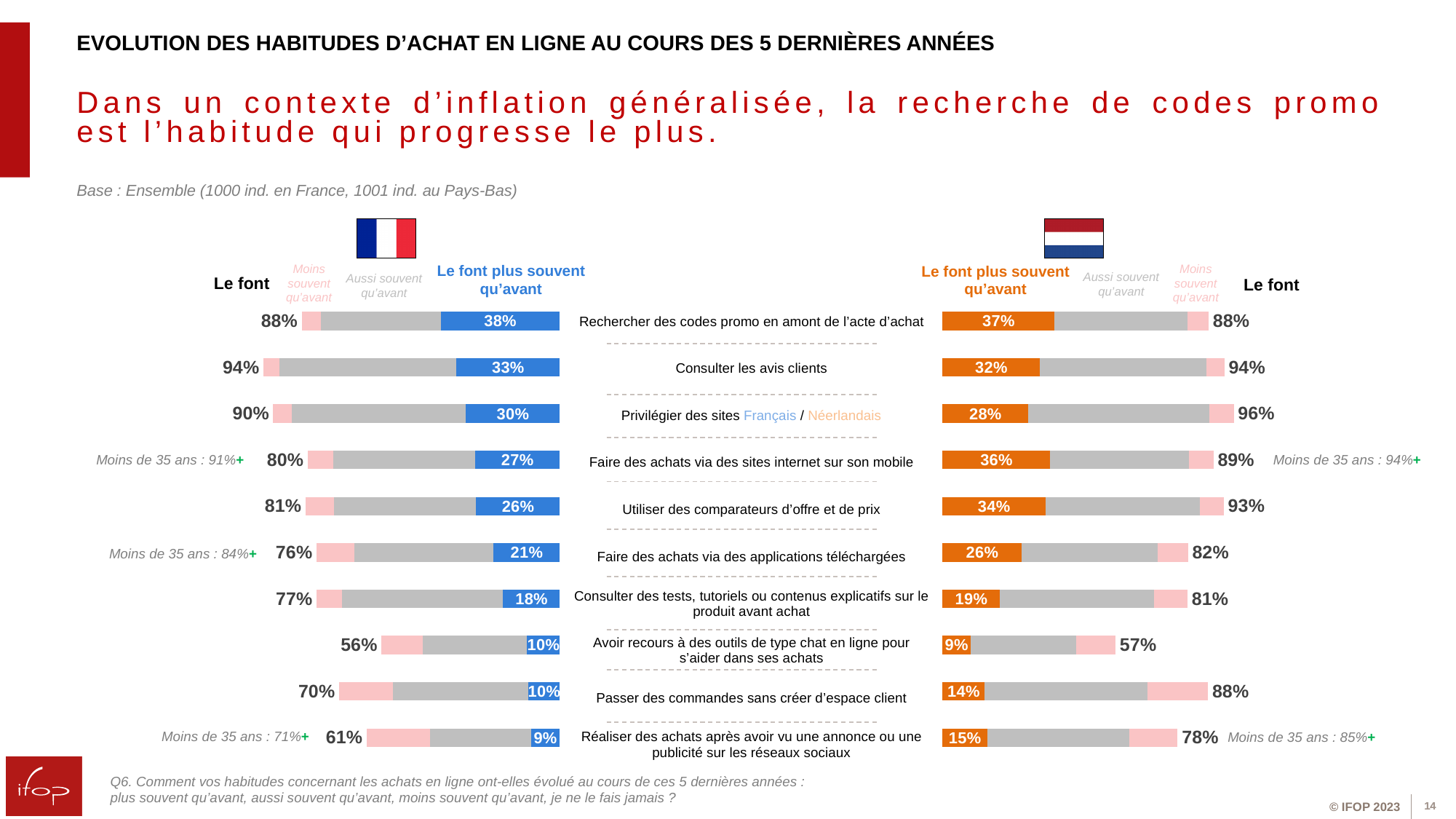
What colour represents "Le font plus souvent qu'avant" in the Netherlands chart (right)? Orange What type of chart is used on this slide? Stacked bar chart For "Privilégier des sites Français / Néerlandais", which country has the higher "Le font" percentage, France or the Netherlands? Netherlands In the France chart (left), which habit has the highest "Le font plus souvent qu'avant" percentage? Rechercher des codes promo en amont de l'acte d'achat How many online shopping habits are listed in the charts? 10 In the France chart (left), which habit has the lowest "Le font" percentage? Avoir recours à des outils de type chat en ligne pour s'aider dans ses achats In the Netherlands chart (right), which habit has the lowest "Le font plus souvent qu'avant" percentage? Avoir recours à des outils de type chat en ligne pour s'aider dans ses achats What is the difference between the France and Netherlands "Le font plus souvent qu'avant" percentages for "Utiliser des comparateurs d'offre et de prix"? 8 points In the France chart (left), what is the "Le font" percentage for "Faire des achats via des applications téléchargées" among those under 35 ("Moins de 35 ans")? 84% In the Netherlands chart (right), what percentage do "Faire des achats via des sites internet sur son mobile" more often than before? 36% In the Netherlands chart (right), what is the "Le font" percentage for "Consulter les avis clients"? 94% In the France chart (left), what percentage say they search for promo codes before buying more often than before ("Le font plus souvent qu'avant")? 38%